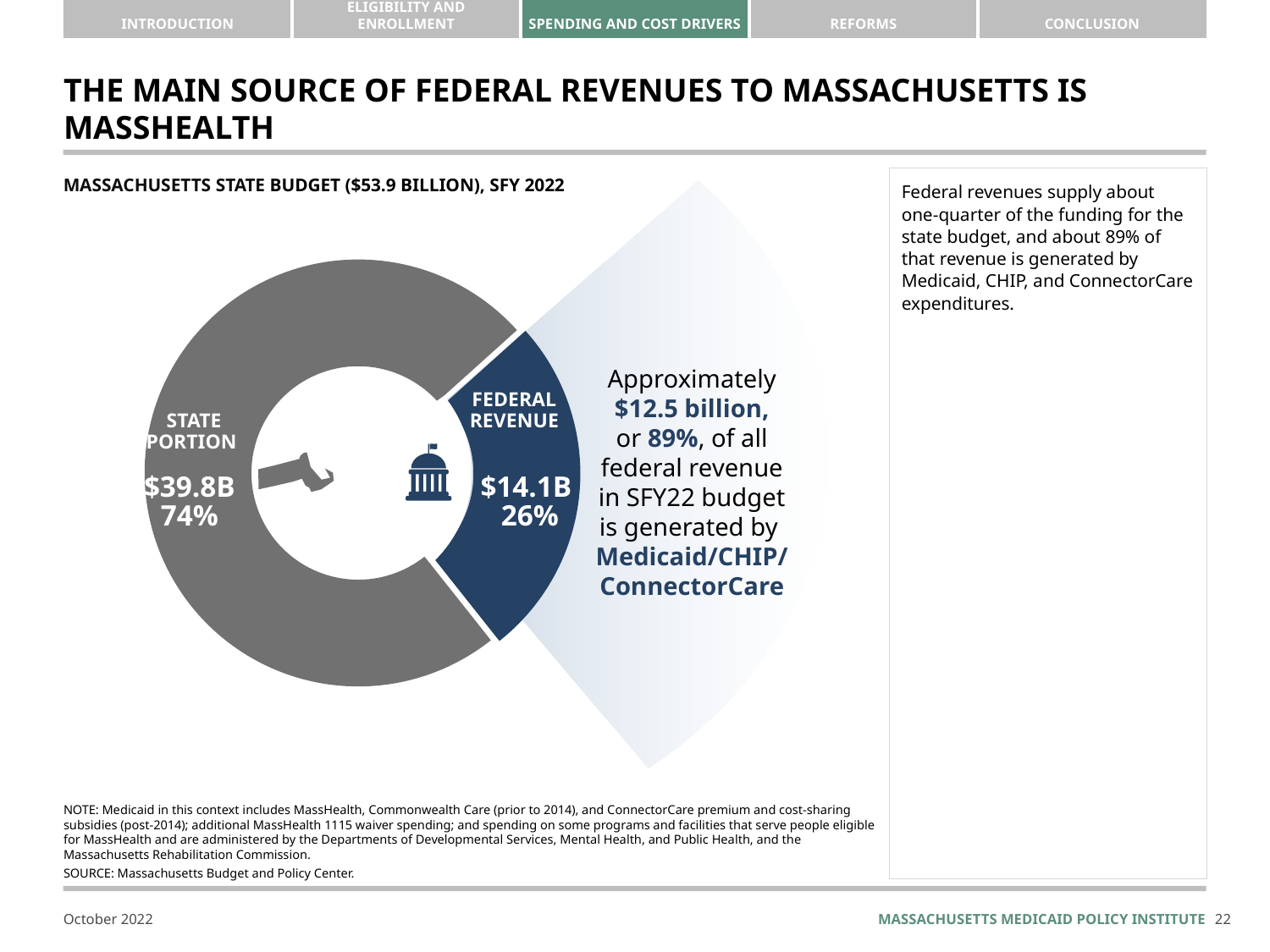
Which segment of the Massachusetts State Budget chart is the largest? State Portion What is the difference in percentage points between the State Portion and Federal Revenue shares? 48 percentage points What is the dollar value of the State Portion in the Massachusetts State Budget chart? $39.8B What is the difference in dollars between the State Portion and Federal Revenue in the chart? $25.7B Which is larger in the Massachusetts State Budget chart, the State Portion or Federal Revenue? State Portion What share of the Massachusetts state budget comes from Federal Revenue? 26% What type of chart is used to show the Massachusetts State Budget? Donut (pie) chart What percentage of the Massachusetts state budget is the State Portion? 74% What total budget amount is stated in the chart title? $53.9 billion How many segments does the Massachusetts State Budget chart have? 2 What is the dollar value of Federal Revenue in the Massachusetts State Budget chart? $14.1B Which segment of the Massachusetts State Budget chart is the smallest? Federal Revenue